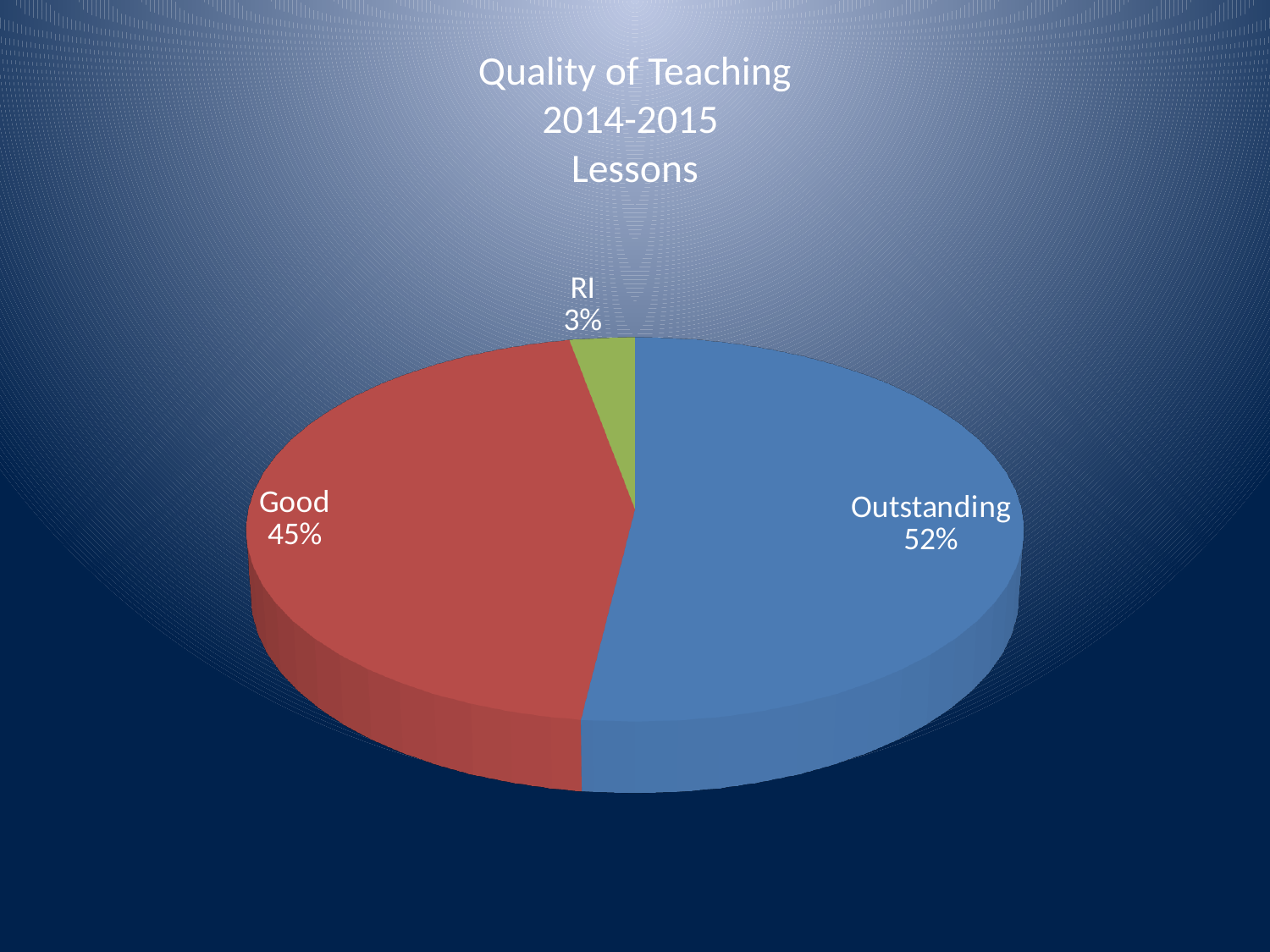
What percentage of lessons were rated RI? 3% How many categories are shown in the pie chart? 3 What kind of chart is shown on the slide? Pie chart Which category has the largest share of the pie? Outstanding What is the title of the chart? Quality of Teaching 2014-2015 Lessons What percentage of lessons were rated Good? 45% What colour is the Outstanding slice? Blue What is the difference in percentage points between Outstanding and Good? 7 Which is larger, the share for Good or the share for RI? Good Which category has the smallest share of the pie? RI What is the difference in percentage points between Good and RI? 42 What percentage of lessons were rated Outstanding? 52%